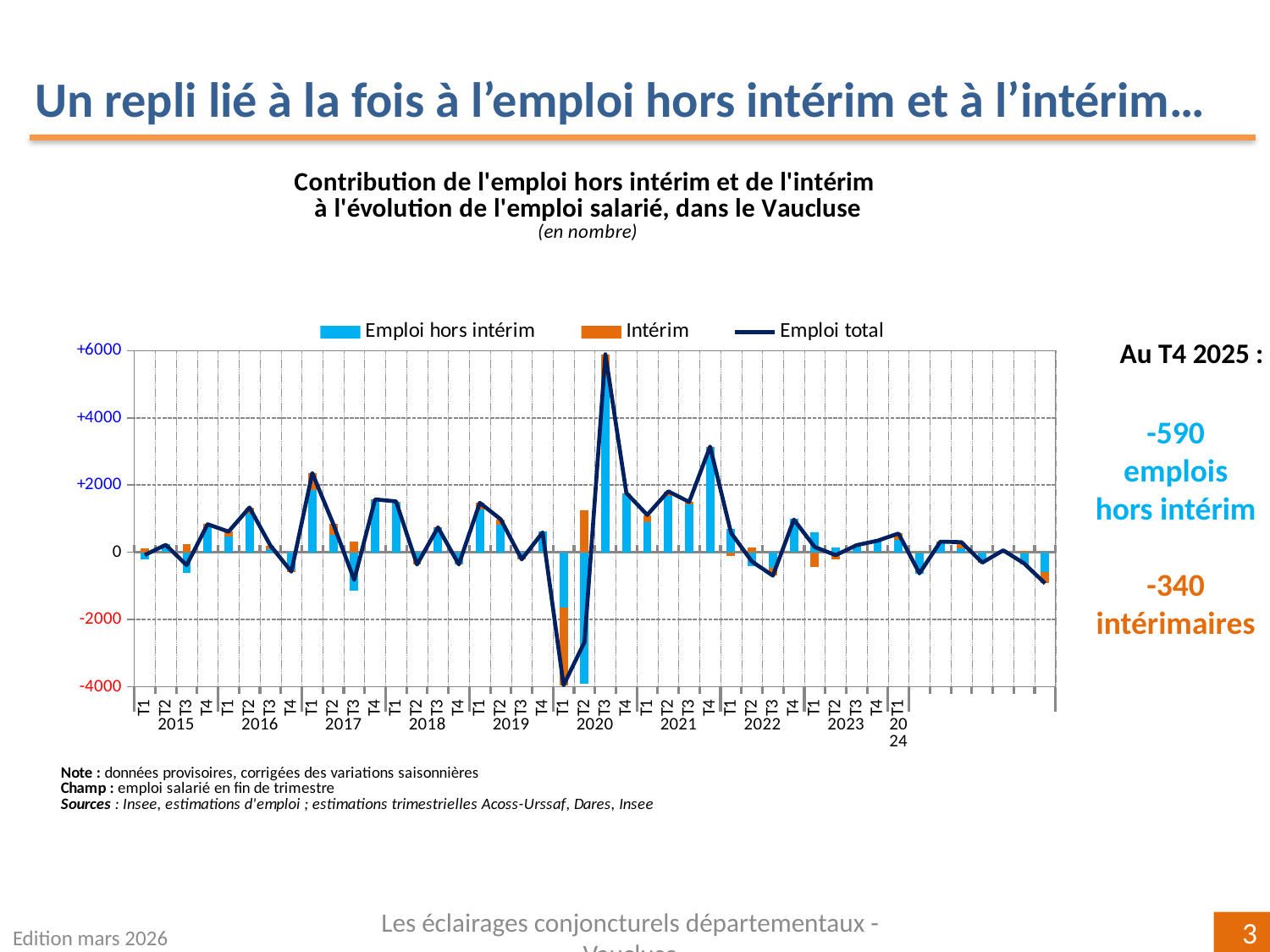
In which quarter does the Emploi total line reach its lowest value? T1 2020 In which quarter does the Emploi total line reach its highest value? T3 2020 How many series does the chart legend list? 3 How many years are labelled on the x axis of the chart? 10 Is the Emploi total value for T1 2020 greater or less than -2000? less Is the Emploi hors intérim value for T3 2017 greater or less than 0? less Which series is drawn as a line rather than bars? Emploi total Which is larger, the Emploi total value for T3 2020 or for T4 2021? T3 2020 What kind of chart is shown on the slide? A combination bar and line chart Is the Emploi total value for T3 2020 greater or less than +4000? greater What colour are the bars for the Intérim series? Orange